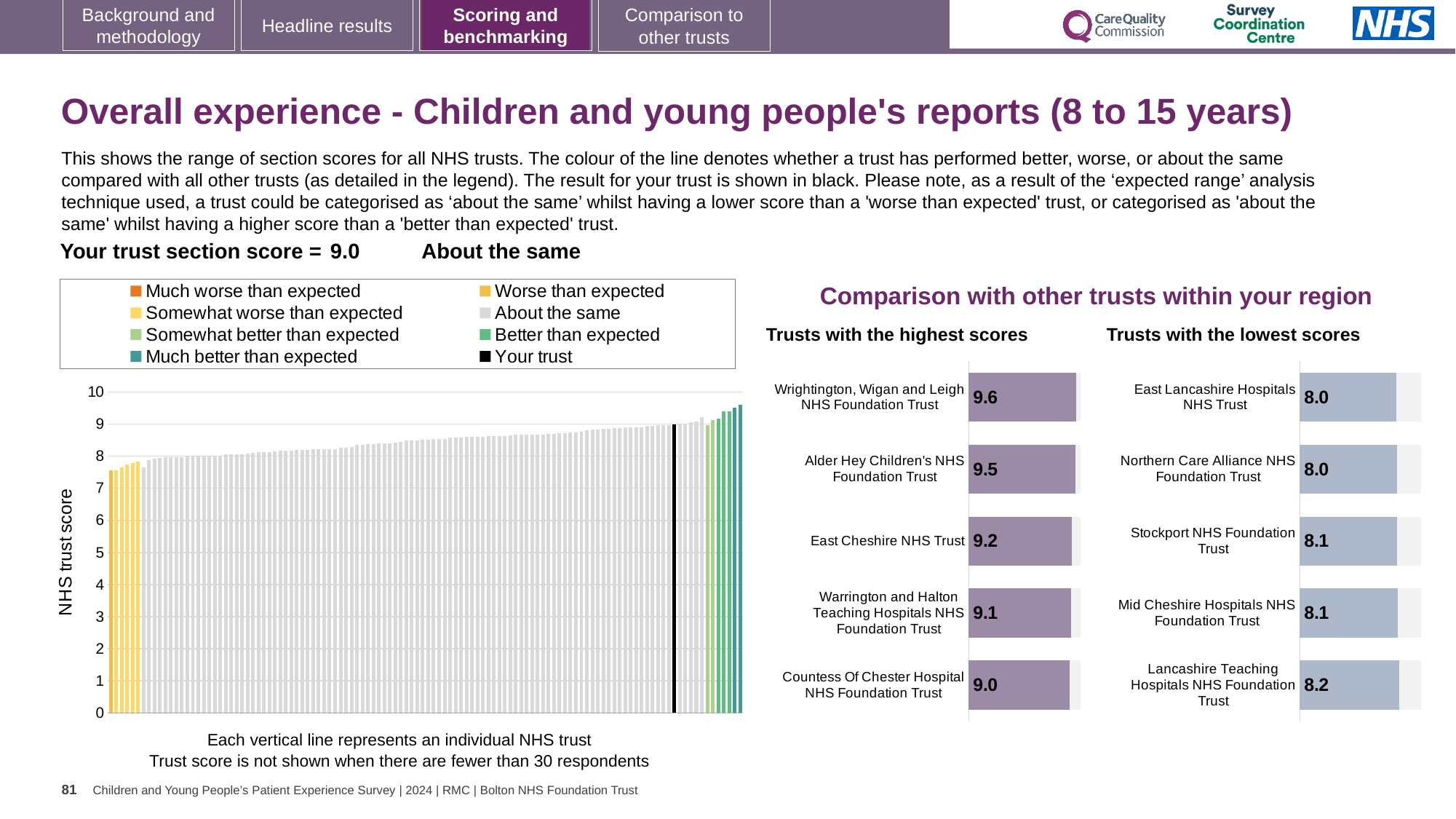
In the 'Trusts with the highest scores' chart, which has the higher score: Alder Hey Children's NHS Foundation Trust or East Cheshire NHS Trust? Alder Hey Children's NHS Foundation Trust In the 'Trusts with the highest scores' chart, what is the difference between the scores of Wrightington, Wigan and Leigh NHS Foundation Trust and Countess Of Chester Hospital NHS Foundation Trust? 0.6 How many entries does the legend above the large 'NHS trust score' chart list? 8 In the 'Trusts with the highest scores' chart, which trust has the lowest score? Countess Of Chester Hospital NHS Foundation Trust How many trusts are shown in the 'Trusts with the lowest scores' chart? 5 What kind of chart is the large 'NHS trust score' chart on the left of the slide? Bar chart In the large 'NHS trust score' chart on the left, is the value of the leftmost (lowest) bar greater or less than 8? less In the 'Trusts with the highest scores' chart, what is the score for Wrightington, Wigan and Leigh NHS Foundation Trust? 9.6 In the 'Trusts with the highest scores' chart, which trust has the highest score? Wrightington, Wigan and Leigh NHS Foundation Trust In the large 'NHS trust score' chart on the left, do the bar values rise or fall from left to right? Rise In the 'Trusts with the lowest scores' chart, what is the score for Lancashire Teaching Hospitals NHS Foundation Trust? 8.2 In the 'Trusts with the lowest scores' chart, which trust has the highest score? Lancashire Teaching Hospitals NHS Foundation Trust